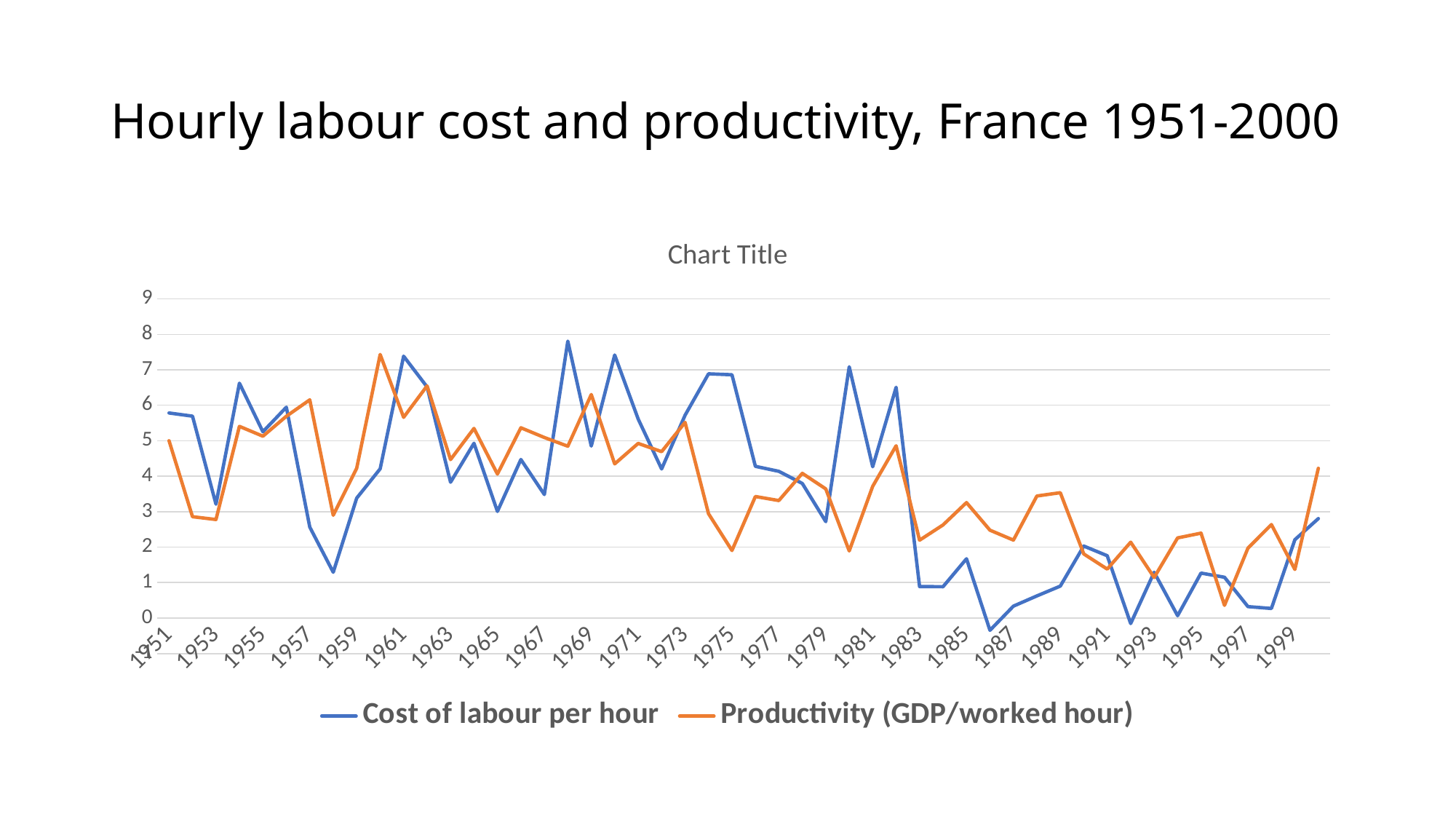
What are the two series named in the legend? Cost of labour per hour; Productivity (GDP/worked hour) Which colour is used for the Productivity (GDP/worked hour) line? Orange How many series does the legend list? 2 Is the value for Cost of labour per hour in 1969 greater or less than 7? less Overall, do the values of both series rise or fall from 1951 to 2000? Fall Is the value for Productivity (GDP/worked hour) in 1975 greater or less than 3? less What kind of chart is shown on the slide? Line chart In which year does the Productivity (GDP/worked hour) line reach its highest value? 1960 In which year does the Productivity (GDP/worked hour) line reach its lowest value? 1996 In which year does the Cost of labour per hour line reach its highest value? 1968 Is the value for Cost of labour per hour in 1959 greater or less than 2? greater In 1975, which series has the higher value: Cost of labour per hour or Productivity (GDP/worked hour)? Cost of labour per hour